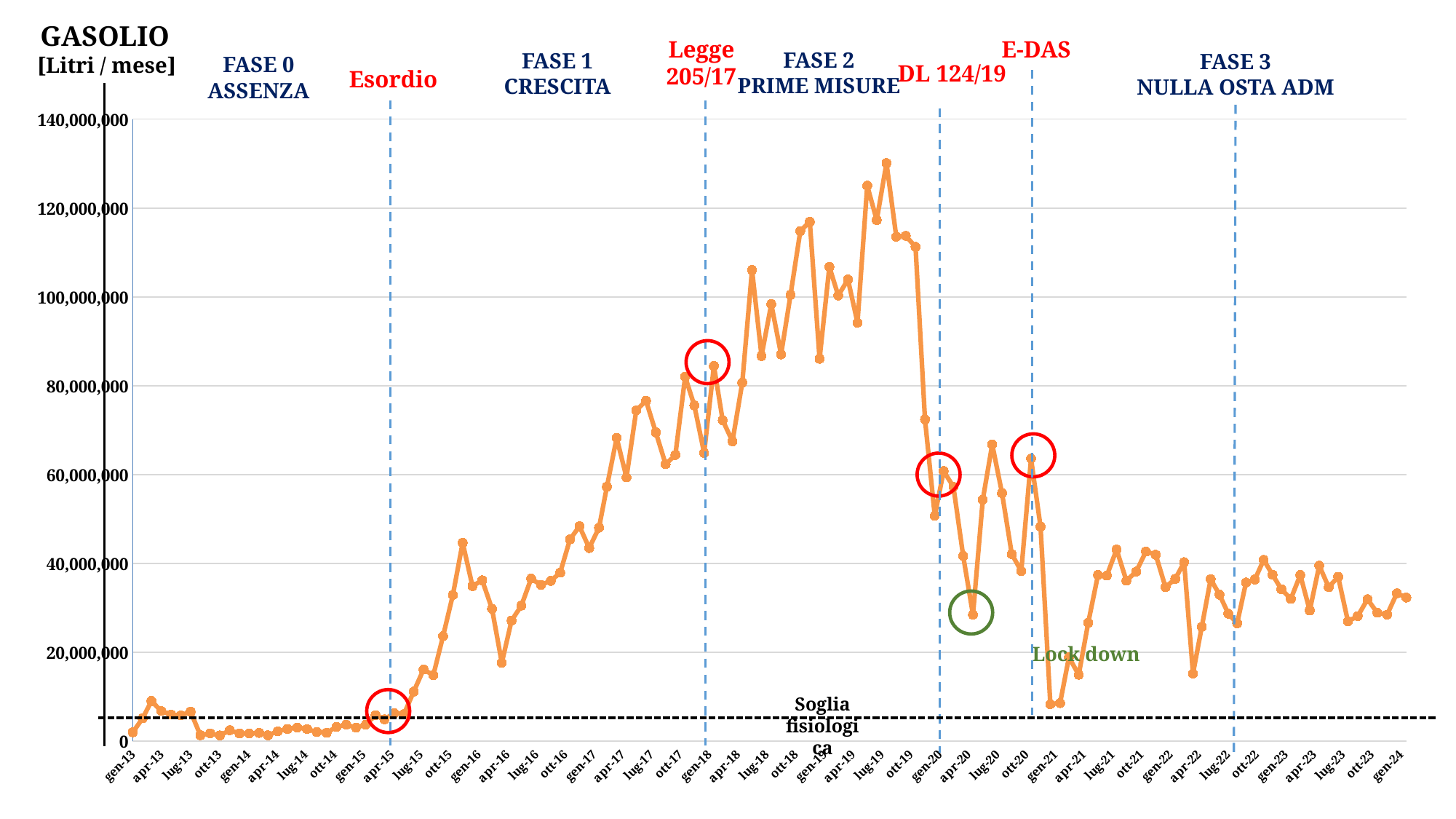
Is the peak value around lug-19 greater or less than 120,000,000? greater Is the value for gen-24 greater or less than 20,000,000? greater Is the value for ott-18 greater or less than 100,000,000? greater Around which month does the line reach its highest value? lug-19 How many data series are plotted on the chart? 1 What kind of chart is shown on the slide? line chart What unit is shown for the vertical axis of the chart? [Litri / mese] Which is larger, the value for lug-19 or the value for gen-20? lug-19 Do the values generally rise or fall between lug-19 and gen-21? fall What is the title of the chart? GASOLIO